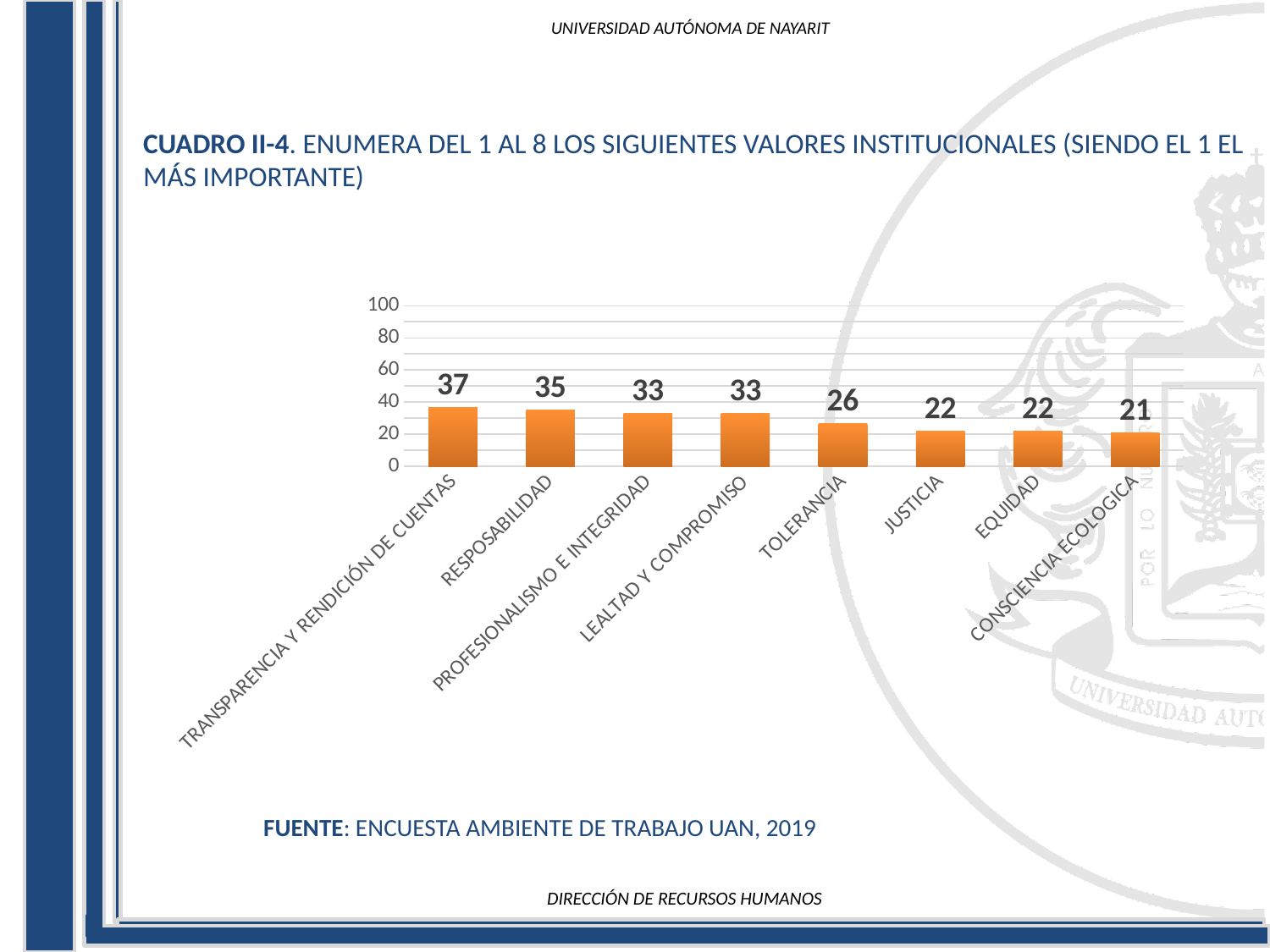
What is the value for CONSCIENCIA ECOLOGICA? 21 What is the value for TRANSPARENCIA Y RENDICIÓN DE CUENTAS? 37 What kind of chart is shown on the slide? bar chart How many categories are shown on the x axis? 8 Do the values rise or fall from left to right along the x axis? fall What is the difference between the values for RESPOSABILIDAD and TOLERANCIA? 9 Which category has the lowest value? CONSCIENCIA ECOLOGICA Is the value for LEALTAD Y COMPROMISO greater or less than 20? greater Which is larger, the value for RESPOSABILIDAD or the value for JUSTICIA? RESPOSABILIDAD Which category has the highest value? TRANSPARENCIA Y RENDICIÓN DE CUENTAS What is the difference between the values for TRANSPARENCIA Y RENDICIÓN DE CUENTAS and CONSCIENCIA ECOLOGICA? 16 What is the value for TOLERANCIA? 26